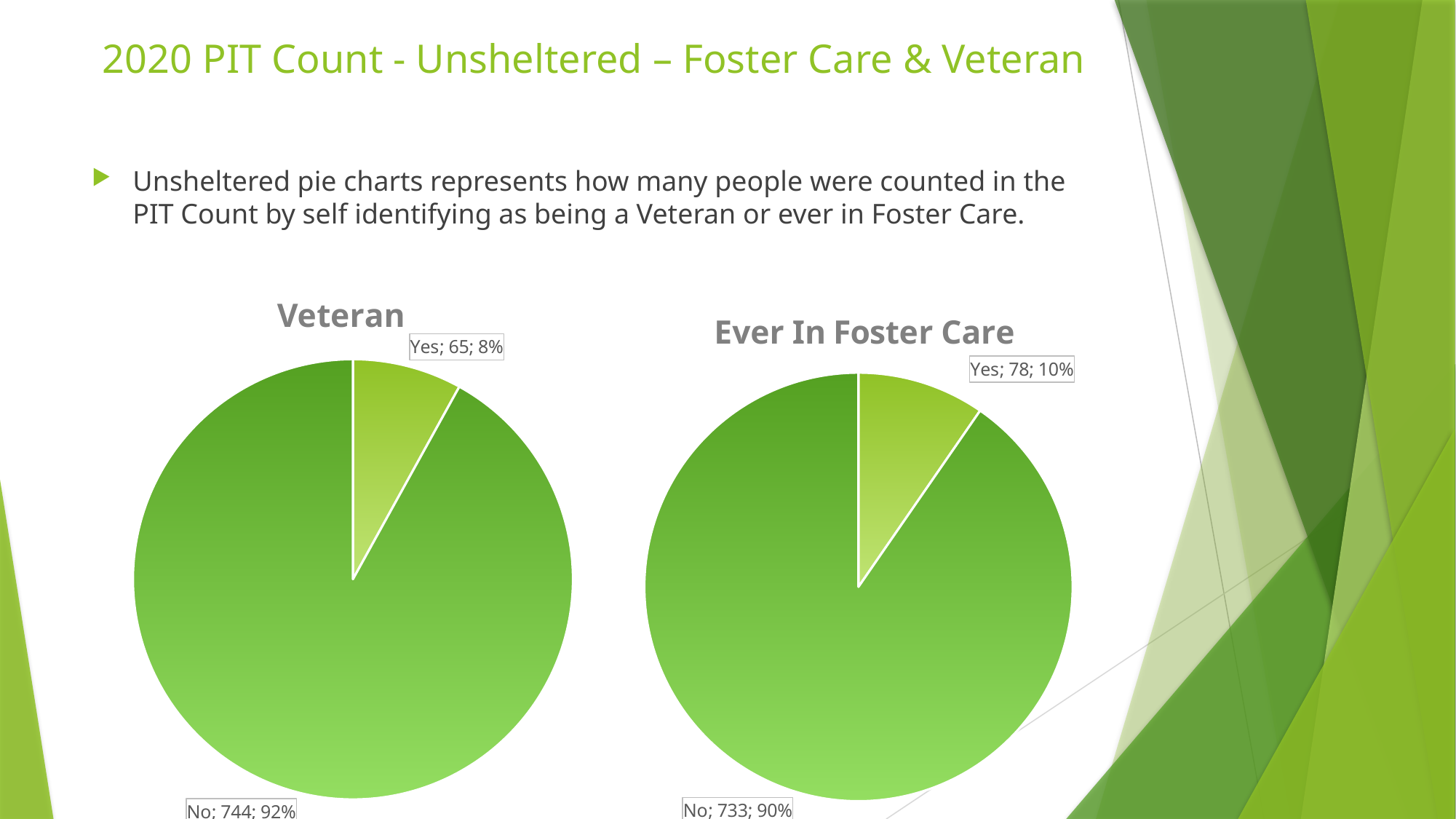
In the Veteran pie chart, which slice is the largest? No In the Veteran pie chart, what is the difference between the No and Yes counts? 679 In the Ever In Foster Care pie chart, how many people are in the No slice? 733 What type of chart is the Veteran chart? Pie chart In the Ever In Foster Care pie chart, how many people are in the Yes slice? 78 In the Ever In Foster Care pie chart, what share of the pie is the No slice? 90% In the Veteran pie chart, what share of the pie is the Yes slice? 8% In the Veteran pie chart, how many people are in the No slice? 744 In the Veteran pie chart, how many people are in the Yes slice? 65 How many slices does the Ever In Foster Care pie chart have? 2 In the Ever In Foster Care pie chart, which slice is the smallest? Yes In the Ever In Foster Care pie chart, what is the total of the Yes and No counts? 811